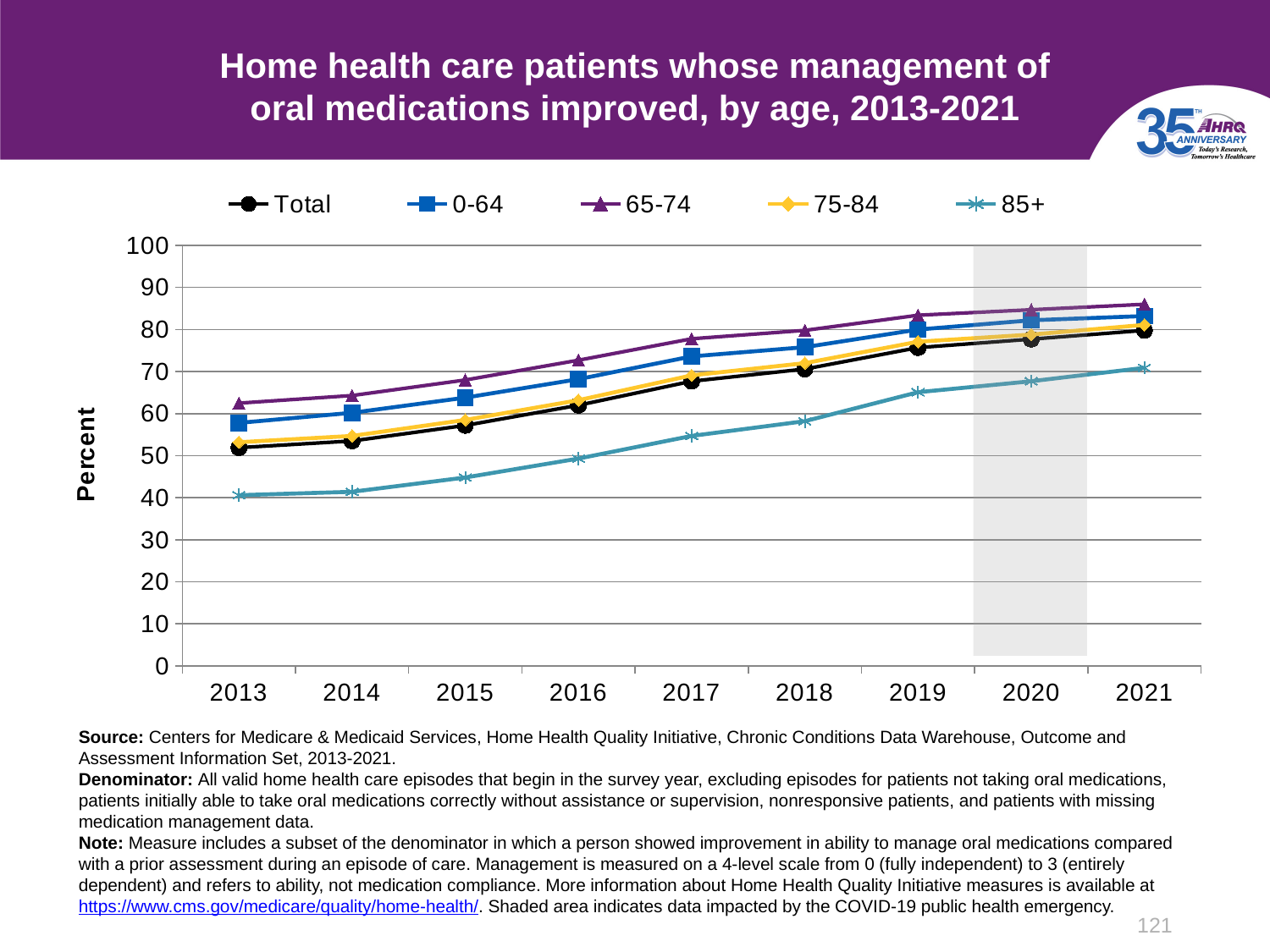
Is the value for the 65-74 group in 2021 greater or less than 80? greater Which age group has the highest value in 2021? 65-74 How many series does the legend list? 5 In 2018, which is larger: the value for 0-64 or the value for 85+? 0-64 Do the values for the Total series rise or fall from 2013 to 2021? Rise Is the value for Total in 2013 greater or less than 60? less Which age group has the lowest value in 2013? 85+ What kind of chart is shown on the slide? Line chart What does the shaded area on the chart indicate? Data impacted by the COVID-19 public health emergency Is the value for the 85+ group in 2013 greater or less than 50? less How many years are plotted along the x axis? 9